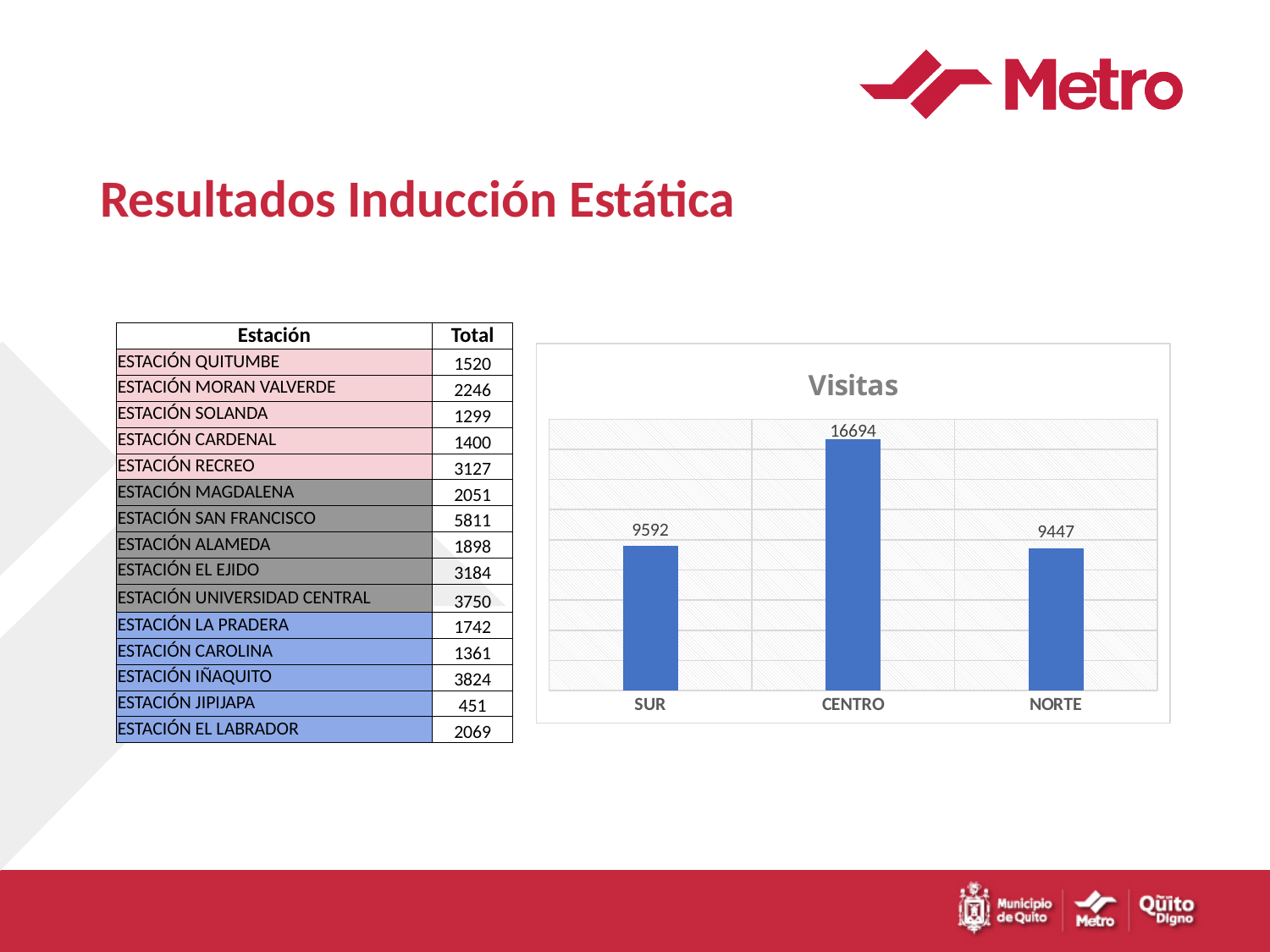
What colour are the bars in the Visitas chart? blue What kind of chart is the Visitas chart? bar chart What is the value for SUR in the Visitas chart? 9592 What is the difference between the values for SUR and NORTE in the Visitas chart? 145 Which is larger in the Visitas chart, the value for CENTRO or the value for NORTE? CENTRO What is the value for NORTE in the Visitas chart? 9447 Which category has the lowest value in the Visitas chart? NORTE What is the value for CENTRO in the Visitas chart? 16694 How many categories are shown in the Visitas chart? 3 What is the difference between the values for CENTRO and SUR in the Visitas chart? 7102 What is the title of the chart on the slide? Visitas Which category has the highest value in the Visitas chart? CENTRO